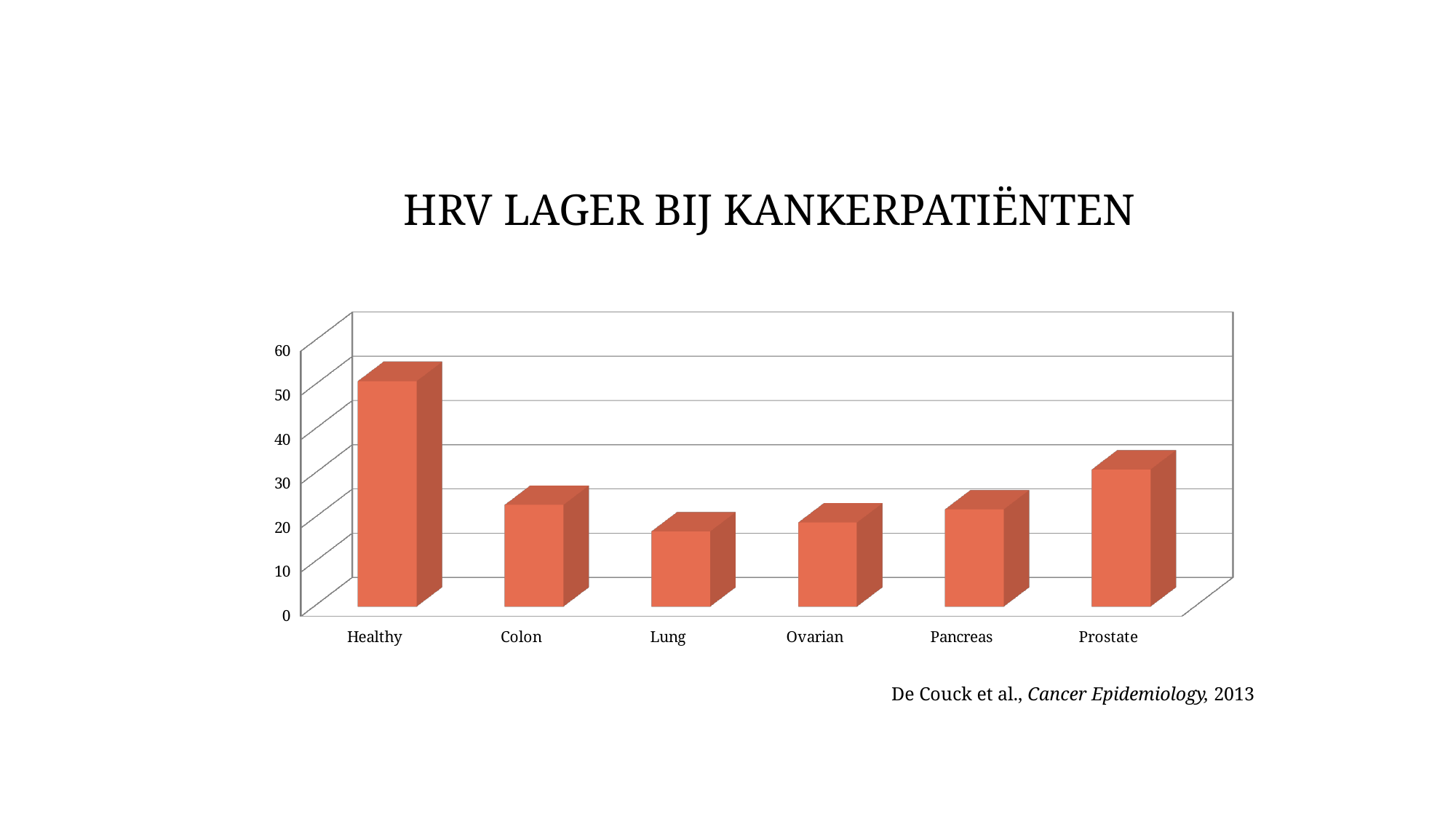
What is the title of the chart on the slide? HRV LAGER BIJ KANKERPATIËNTEN Is the value for Lung greater or less than 30? less How many categories are shown on the x axis of the chart? 6 What kind of chart is shown on the slide? bar chart Is the value for Prostate greater or less than 40? less Which is larger, the value for Healthy or the value for Prostate? Healthy Which category has the highest value in the chart? Healthy Is the value for Prostate greater or less than 20? greater Which is larger, the value for Prostate or the value for Colon? Prostate Which category has the lowest value in the chart? Lung